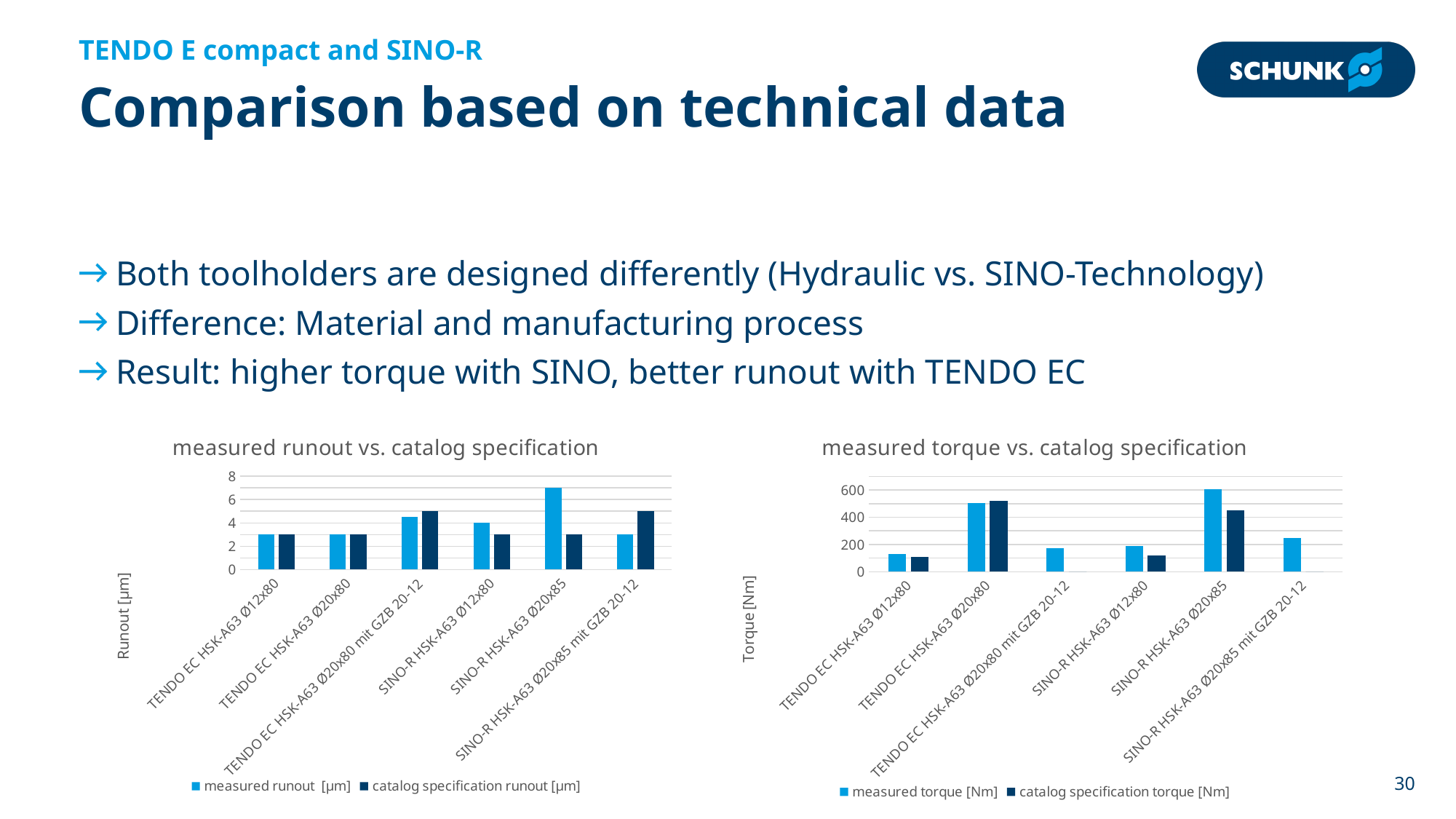
On the 'measured runout vs. catalog specification' chart, for SINO-R HSK-A63 Ø20x85, which is larger: the measured runout or the catalog specification runout? measured runout On the 'measured runout vs. catalog specification' chart, which category has the highest measured runout? SINO-R HSK-A63 Ø20x85 On the 'measured runout vs. catalog specification' chart, is the measured runout for SINO-R HSK-A63 Ø20x85 greater or less than 6? greater On the 'measured torque vs. catalog specification' chart, how many series does the legend list? 2 On the 'measured torque vs. catalog specification' chart, is the measured torque for TENDO EC HSK-A63 Ø12x80 greater or less than 200? less On the 'measured runout vs. catalog specification' chart, what kind of chart is shown? bar chart On the 'measured torque vs. catalog specification' chart, is the measured torque for TENDO EC HSK-A63 Ø20x80 greater or less than 400? greater On the 'measured torque vs. catalog specification' chart, which category has the highest measured torque? SINO-R HSK-A63 Ø20x85 On the 'measured torque vs. catalog specification' chart, for SINO-R HSK-A63 Ø20x85, which is larger: the measured torque or the catalog specification torque? measured torque On the 'measured runout vs. catalog specification' chart, how many series does the legend list? 2 On the 'measured runout vs. catalog specification' chart, what is the label of the vertical axis? Runout [µm] On the 'measured runout vs. catalog specification' chart, how many toolholder categories are shown on the x axis? 6